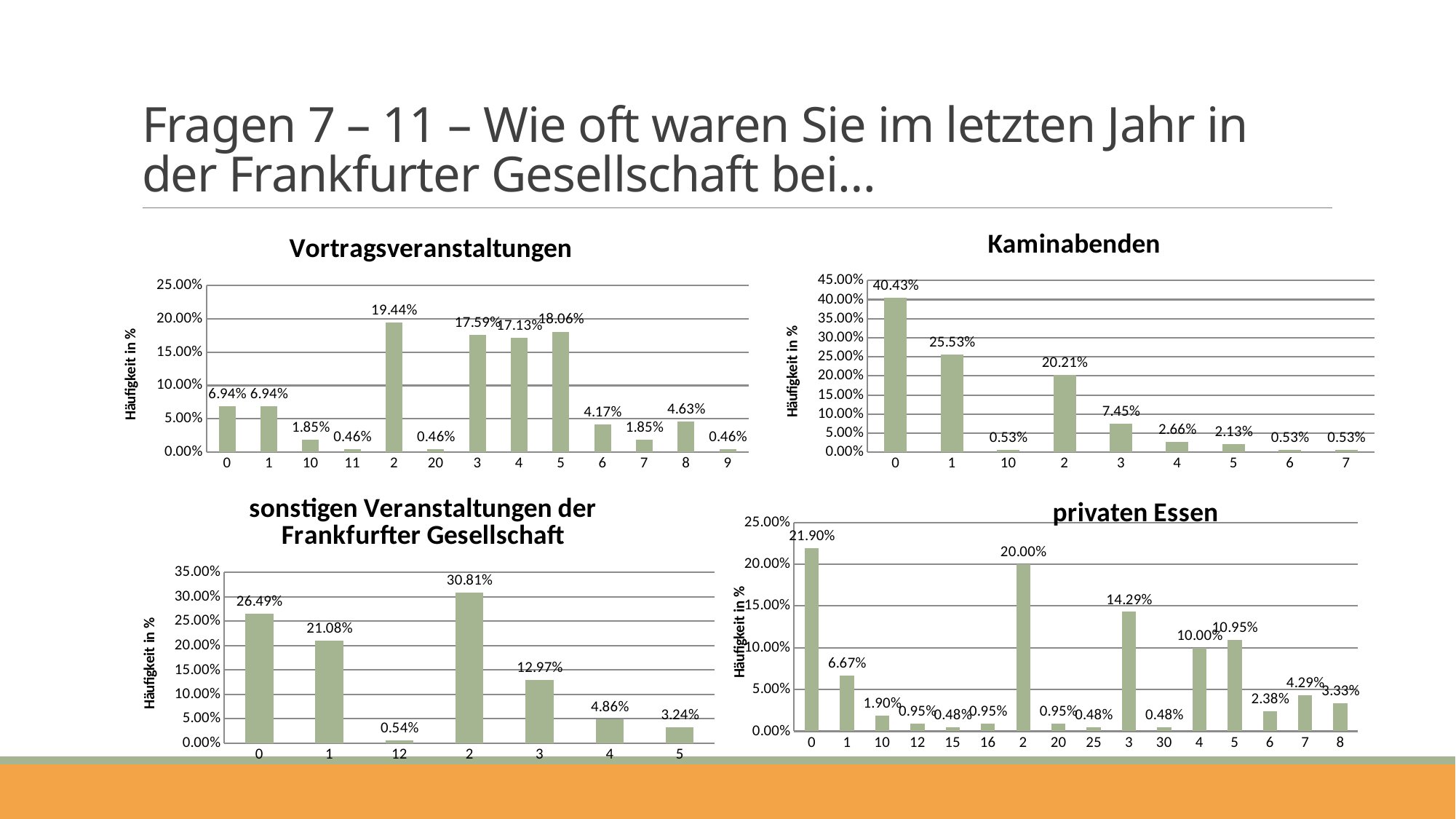
In the Vortragsveranstaltungen chart, what is the value for category 2? 19.44% What type of chart is the privaten Essen chart? bar chart In the sonstigen Veranstaltungen der Frankfurter Gesellschaft chart, which category has the lowest value? 12 In the privaten Essen chart, how many categories are shown on the x axis? 16 In the privaten Essen chart, what is the value for category 3? 14.29% In the Kaminabenden chart, what is the difference between the values for category 0 and category 1? 14.90% In the Vortragsveranstaltungen chart, how many categories are shown on the x axis? 13 In the Vortragsveranstaltungen chart, which category has the highest value? 2 In the Kaminabenden chart, is the value for category 2 greater or less than 25.00%? less In the sonstigen Veranstaltungen der Frankfurter Gesellschaft chart, what is the value for category 3? 12.97% In the Kaminabenden chart, what is the value for category 0? 40.43% In the sonstigen Veranstaltungen der Frankfurter Gesellschaft chart, which is larger, the value for category 0 or category 2? 2